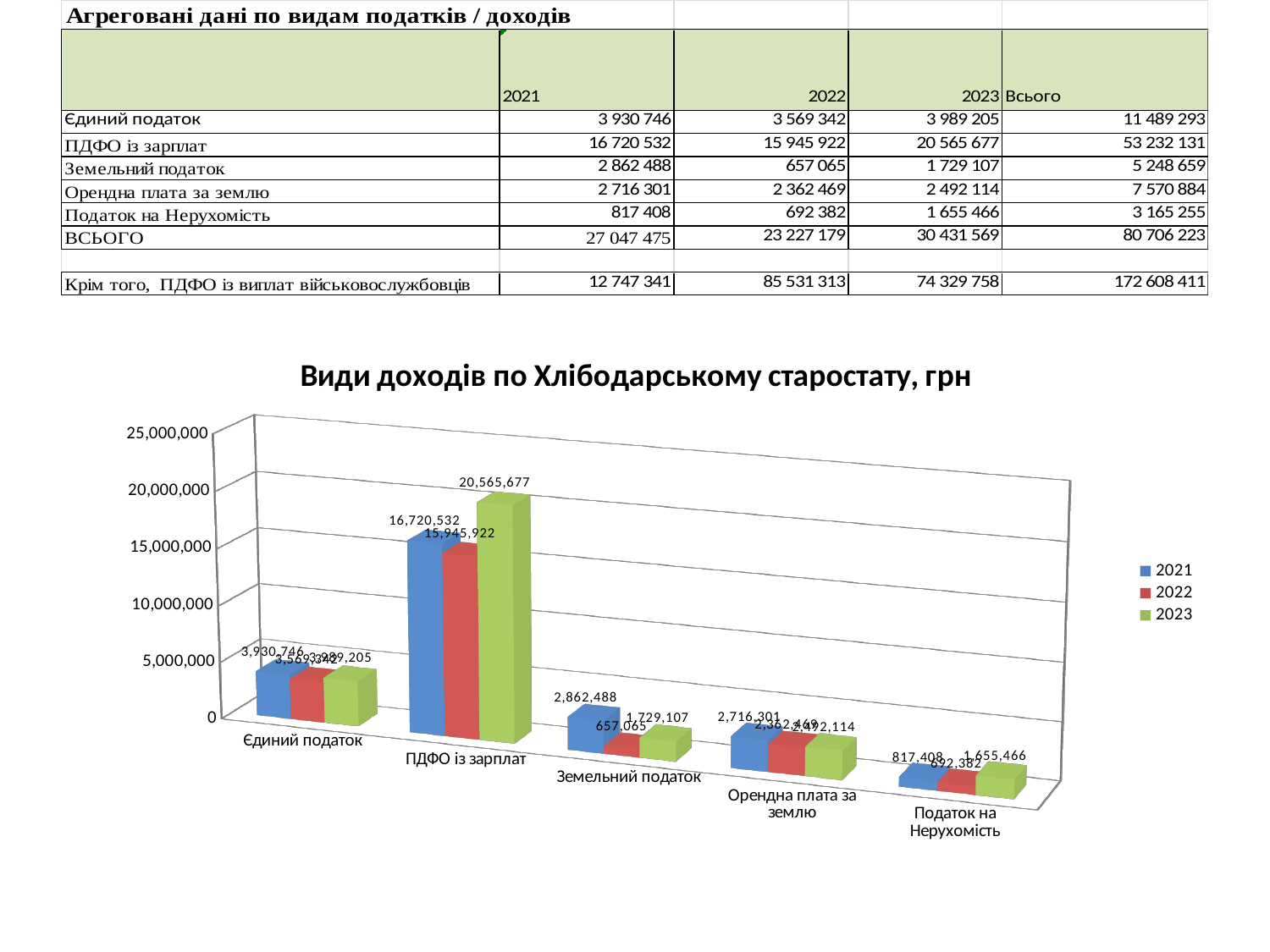
What is the difference between the 2023 and 2021 values for ПДФО із зарплат? 3,845,145 What is the title of the chart? Види доходів по Хлібодарському старостату, грн How many series does the chart legend list? 3 What is the value for Земельний податок in 2022 on the chart? 657,065 What is the value for Податок на Нерухомість in 2023 on the chart? 1,655,466 What kind of chart is shown on the slide? bar chart How many categories are shown on the x axis of the chart? 5 Is the 2021 value for Єдиний податок greater or less than 5,000,000? less What is the value for ПДФО із зарплат in 2023 on the chart? 20,565,677 Which category has the highest value in the 2023 series? ПДФО із зарплат Which category has the lowest value in the 2021 series? Податок на Нерухомість What is the value for ПДФО із зарплат in 2021 on the chart? 16,720,532